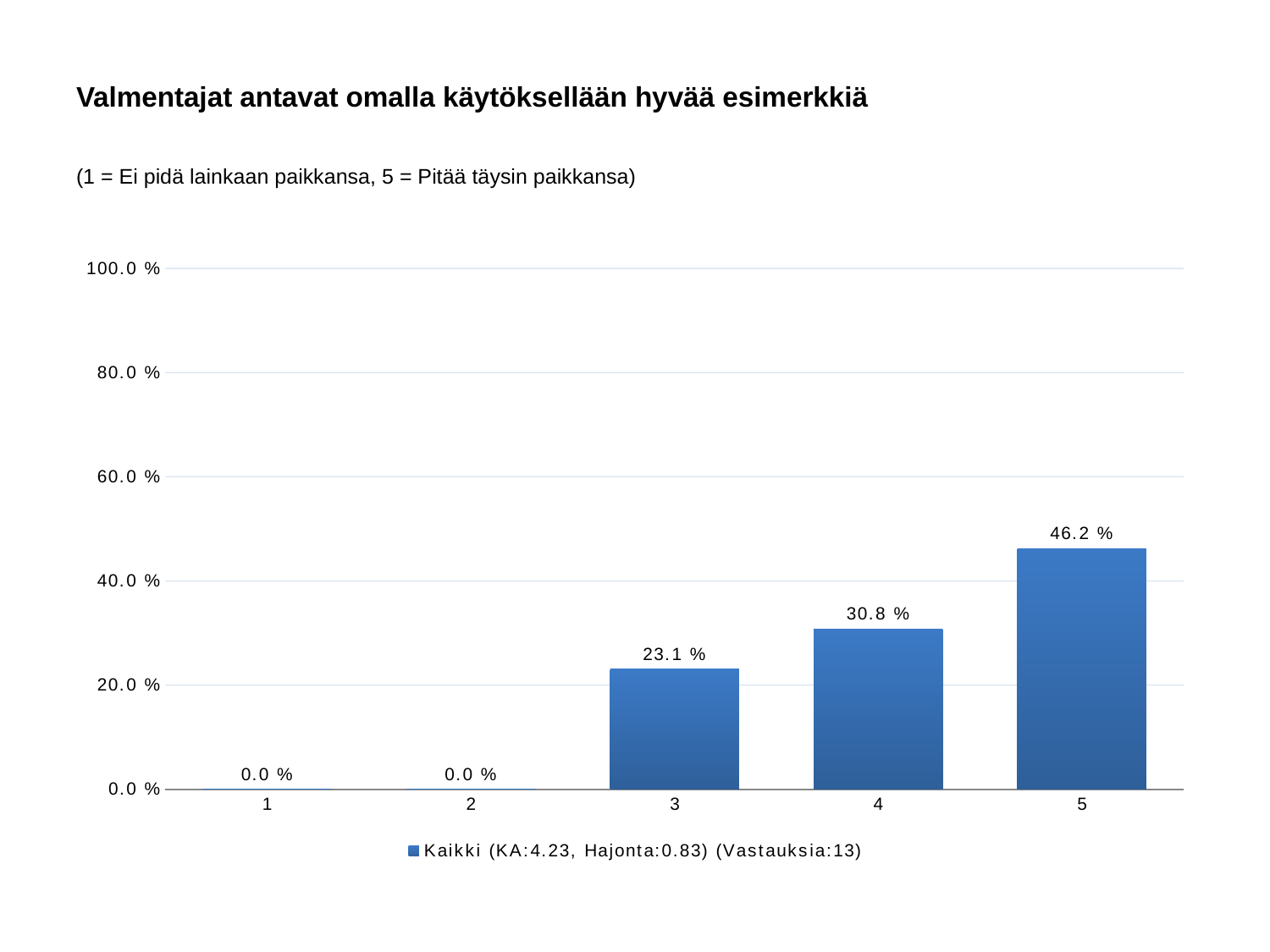
What is the value for category 4? 30.8 % How many categories are shown on the x axis? 5 What is the value for category 1? 0.0 % What is the value for category 3? 23.1 % What is the difference between the values for categories 4 and 3? 7.7 % Is the value for category 5 greater or less than 40.0 %? greater What kind of chart is shown on the slide? bar chart What is the value for category 5? 46.2 % Do the values rise or fall from category 1 to category 5? rise What is the difference between the values for categories 5 and 4? 15.4 % Which category has the highest value? 5 Which is larger, the value for category 3 or the value for category 5? 5